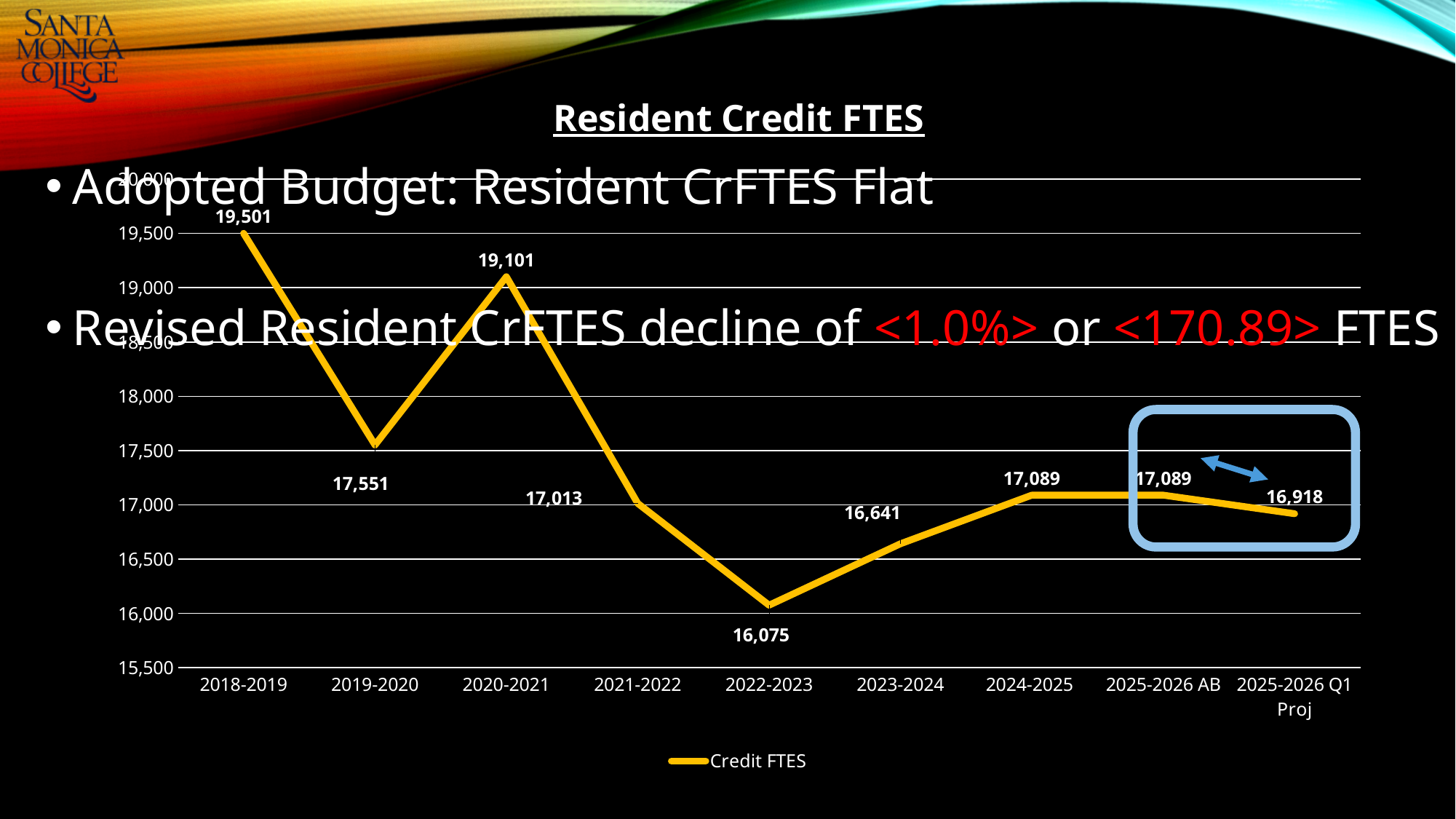
What kind of chart is shown on the slide? line chart Which year has the lowest Credit FTES? 2022-2023 What is the Credit FTES value for 2018-2019? 19,501 What is the title of the chart? Resident Credit FTES What is the difference in Credit FTES between 2025-2026 AB and 2025-2026 Q1 Proj? 171 What is the Credit FTES value for 2025-2026 Q1 Proj? 16,918 How many years (categories) are plotted on the x axis? 9 What is the difference in Credit FTES between 2018-2019 and 2019-2020? 1,950 What is the Credit FTES value for 2022-2023? 16,075 Which is larger, the Credit FTES for 2020-2021 or for 2021-2022? 2020-2021 Which year has the highest Credit FTES? 2018-2019 Is the Credit FTES value for 2023-2024 greater or less than 17,000? less